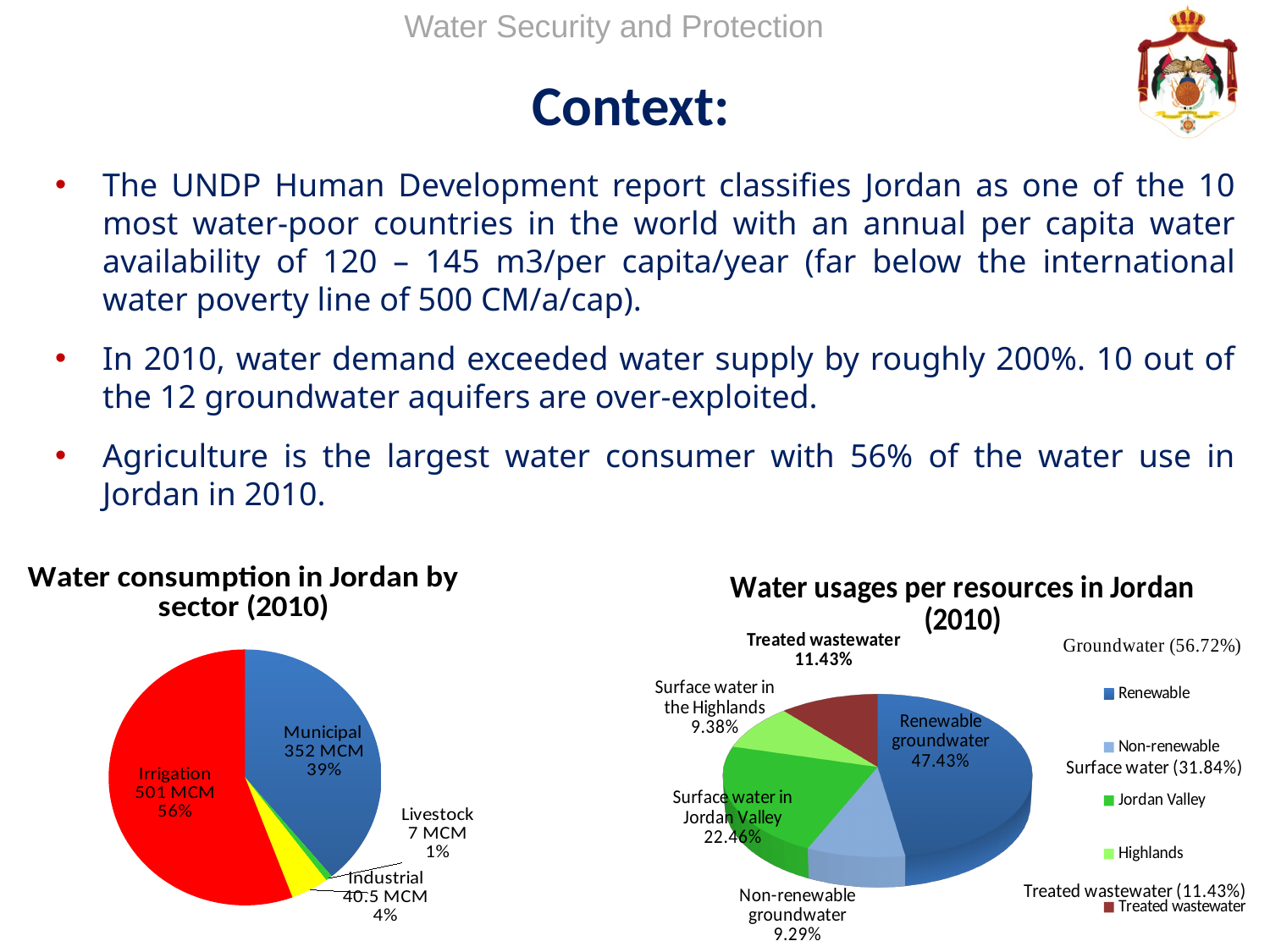
In the 'Water usages per resources in Jordan (2010)' chart, what is the combined percentage shown for Groundwater? 56.72% In the 'Water consumption in Jordan by sector (2010)' chart, what share of water consumption is Irrigation? 56% In the 'Water usages per resources in Jordan (2010)' chart, what percentage is Renewable groundwater? 47.43% In the 'Water consumption in Jordan by sector (2010)' chart, how many sectors are shown? 4 What type of chart is 'Water consumption in Jordan by sector (2010)'? Pie chart In the 'Water usages per resources in Jordan (2010)' chart, how many entries does the legend list? 5 In the 'Water consumption in Jordan by sector (2010)' chart, what is the difference in MCM between Irrigation and Municipal consumption? 149 MCM In the 'Water consumption in Jordan by sector (2010)' chart, which sector has the largest share? Irrigation In the 'Water usages per resources in Jordan (2010)' chart, what percentage is Surface water in Jordan Valley? 22.46% In the 'Water usages per resources in Jordan (2010)' chart, which is larger: Treated wastewater or Non-renewable groundwater? Treated wastewater In the 'Water consumption in Jordan by sector (2010)' chart, which sector has the smallest share? Livestock In the 'Water consumption in Jordan by sector (2010)' chart, how much water does the Municipal sector consume? 352 MCM